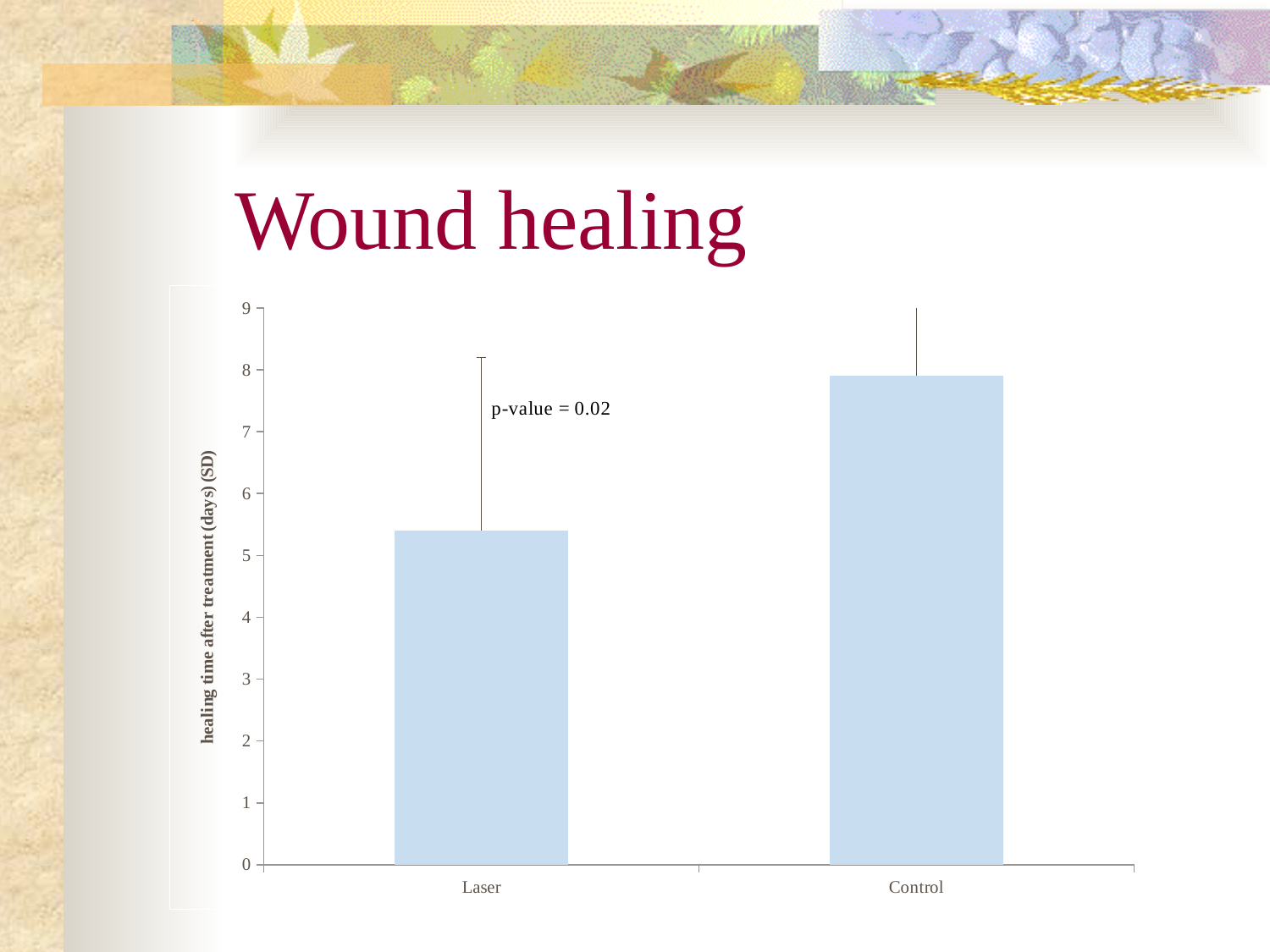
What p-value is annotated on the chart? p-value = 0.02 What kind of chart is shown on the slide? bar chart Is the value for Control greater or less than 9? less Is the value for Control greater or less than 7? greater Is the value for Laser greater or less than 5? greater What is the title of the slide containing the chart? Wound healing Which category has the highest healing time after treatment? Control Which category has the lowest healing time after treatment? Laser How many categories are plotted on the x axis? 2 Which has a larger healing time after treatment, Laser or Control? Control